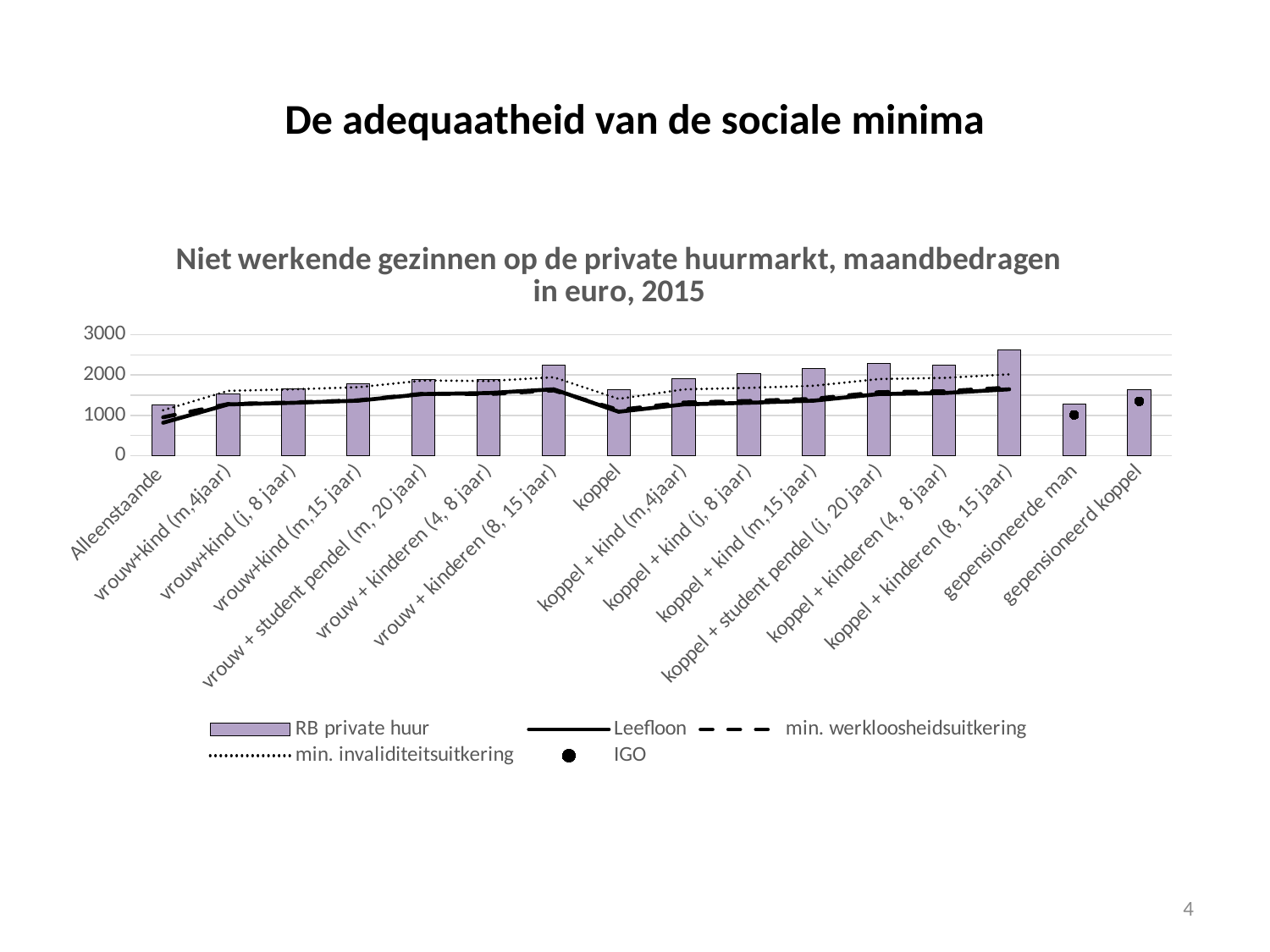
Do the RB private huur bars rise or fall from Alleenstaande to vrouw + kinderen (8, 15 jaar)? rise Which series is plotted as dots rather than bars or lines? IGO Is the IGO value for gepensioneerd koppel greater or less than 1000? greater Is the RB private huur value for vrouw + kinderen (8, 15 jaar) greater or less than 2000? greater Is the RB private huur value for koppel + kinderen (8, 15 jaar) greater or less than 2000? greater Which has the larger RB private huur bar: koppel or koppel + kinderen (8, 15 jaar)? koppel + kinderen (8, 15 jaar) Which category has the highest RB private huur bar? koppel + kinderen (8, 15 jaar) What is the title of the chart? Niet werkende gezinnen op de private huurmarkt, maandbedragen in euro, 2015 How many series does the legend list? 5 How many categories are shown on the x axis? 16